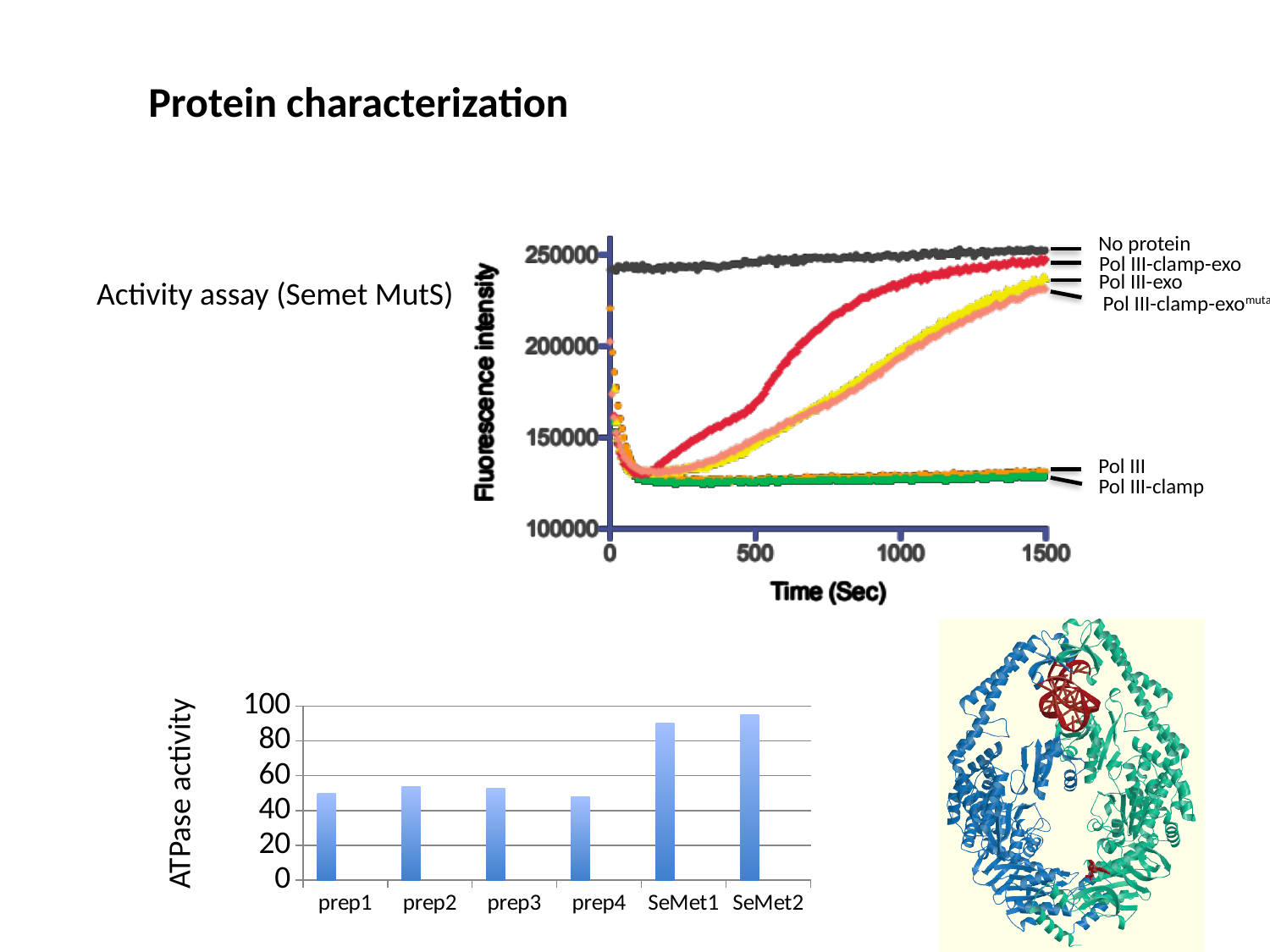
What is the y-axis label of the bottom-left bar chart? ATPase activity In the bottom-left ATPase activity bar chart, is the value for prep1 greater or less than 60? less In the top activity assay chart, is the fluorescence intensity for Pol III at 1500 seconds greater or less than 150000? less In the bottom-left ATPase activity bar chart, is the value for prep4 greater or less than 60? less In the bottom-left ATPase activity bar chart, which is larger, the value for SeMet1 or the value for prep2? SeMet1 What is the x-axis label of the top activity assay chart? Time (Sec) In the bottom-left ATPase activity bar chart, which category has the highest value? SeMet2 In the bottom-left bar chart, how many categories are shown on the x axis? 6 In the top activity assay chart, which labelled series has the highest fluorescence intensity at 1500 seconds? No protein What kind of chart is the bottom-left chart labelled ATPase activity? bar chart